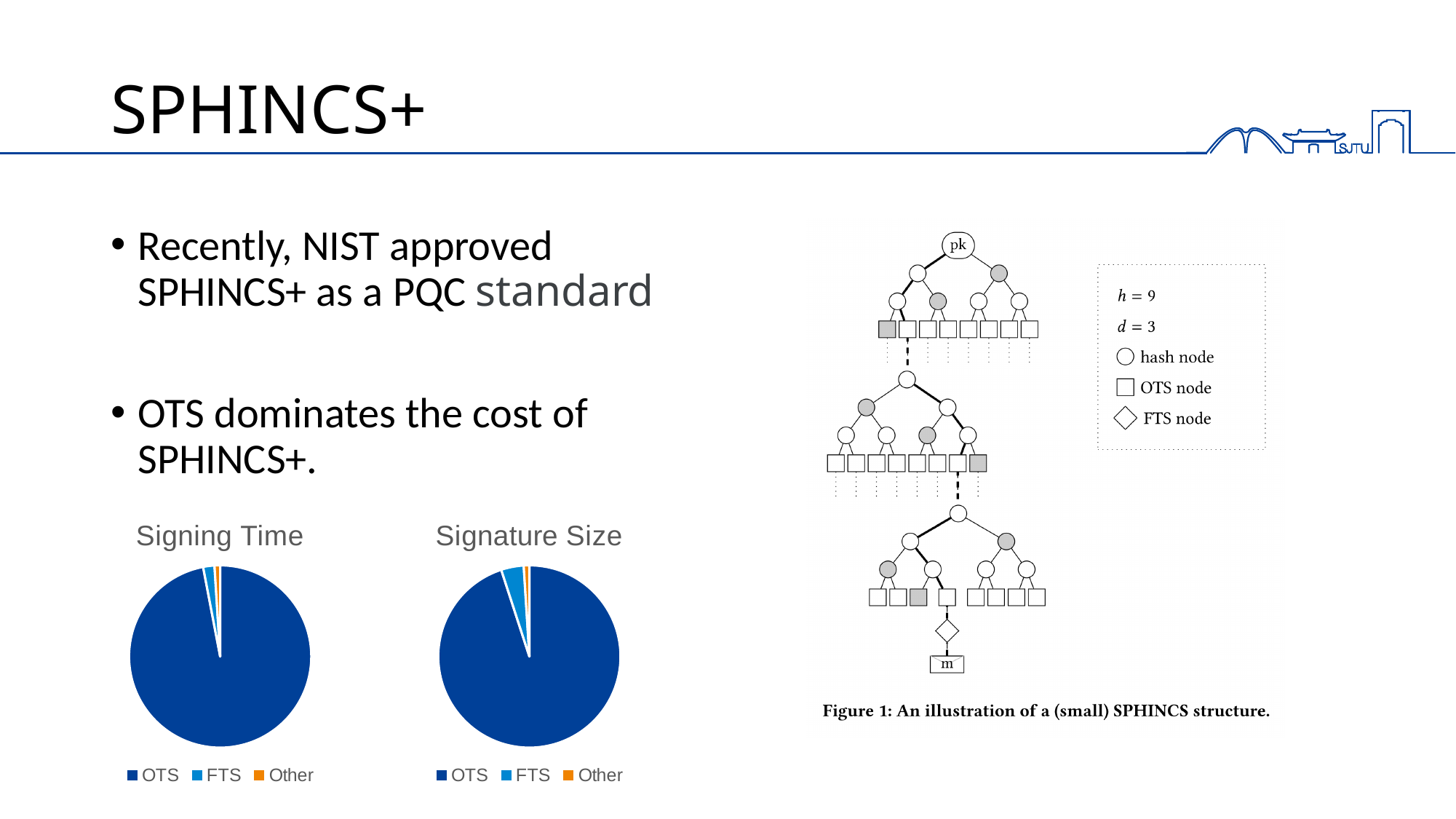
What kind of chart is the "Signing Time" chart? pie chart In the "Signature Size" chart, what colour is the OTS slice? dark blue What are the legend entries of the "Signing Time" chart? OTS, FTS, Other In the "Signing Time" chart, which category has the largest slice? OTS How many entries does the legend of the "Signature Size" chart list? 3 In the "Signature Size" chart, which category has the smallest slice? Other In the "Signature Size" chart, which category has the largest slice? OTS What kind of chart is the "Signature Size" chart? pie chart How many pie charts are shown on the slide? 2 In the "Signature Size" chart, which slice is larger, FTS or Other? FTS How many slices does the "Signing Time" pie chart have? 3 In the "Signing Time" chart, which slice is larger, OTS or FTS? OTS